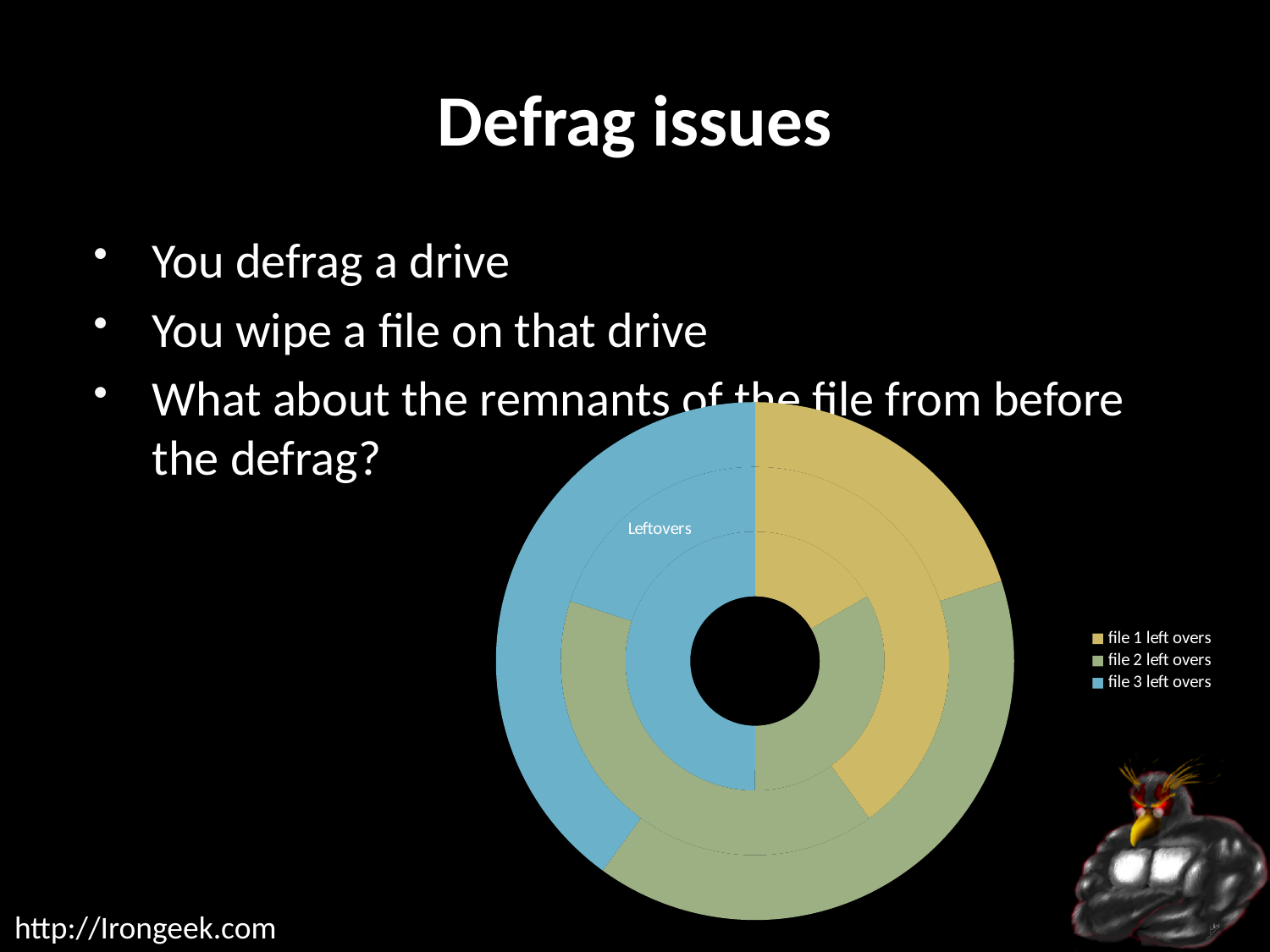
What kind of chart is shown on the slide? doughnut chart In the outermost ring of the doughnut chart, which series takes the smallest share? file 1 left overs Which legend entry is shown in blue? file 3 left overs How many series does the chart legend list? 3 In the innermost ring of the doughnut chart, which series takes the smallest share? file 1 left overs In the innermost ring, which is larger: the share for file 3 left overs or the share for file 2 left overs? file 3 left overs What colour represents 'file 1 left overs' in the chart? yellow In the outermost ring, which is larger: the share for file 2 left overs or the share for file 1 left overs? file 2 left overs How many concentric rings does the doughnut chart have? 3 In the innermost ring of the doughnut chart, which series takes the largest share? file 3 left overs